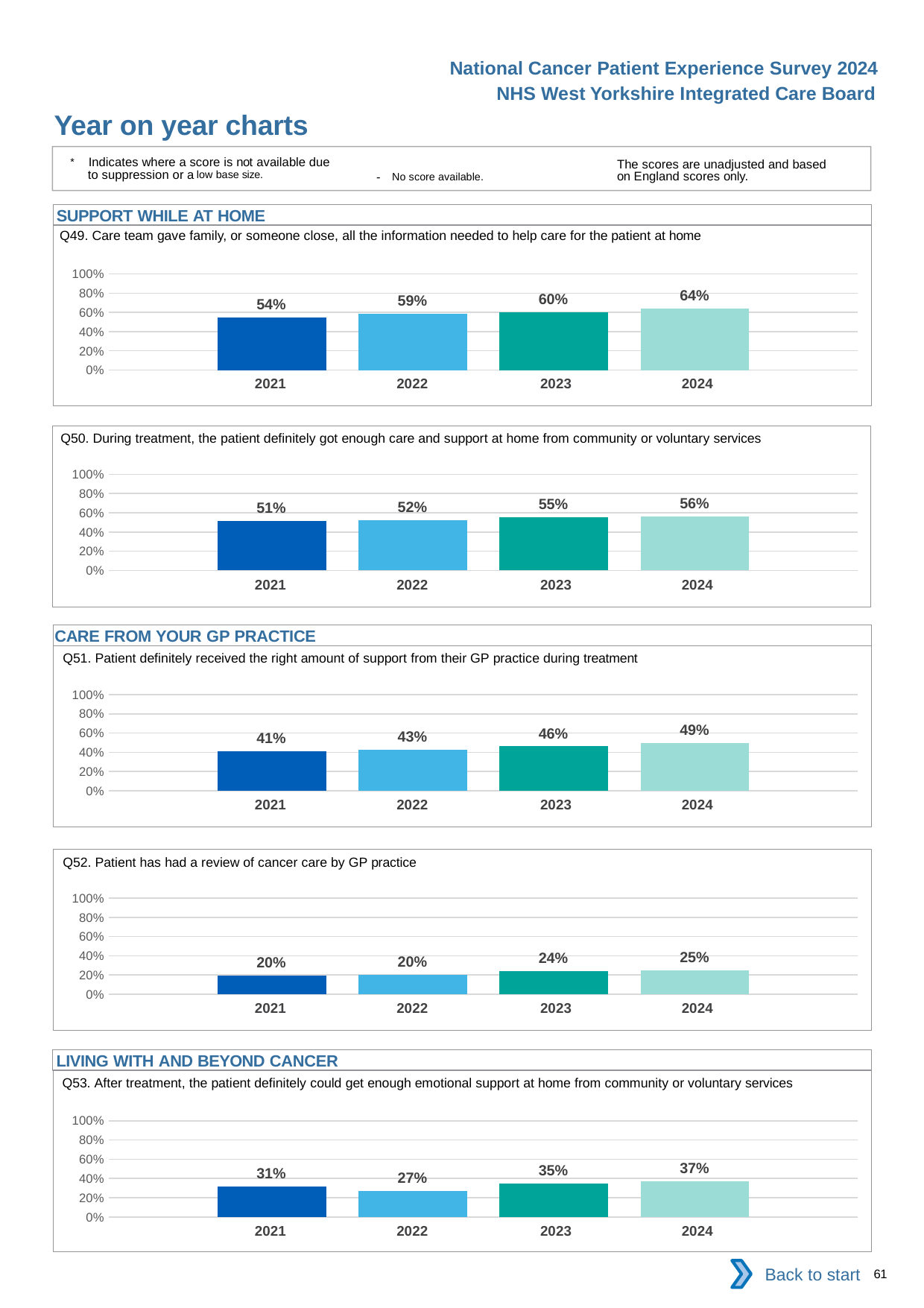
In the Q49 chart, what is the value for 2024? 64% How many years are shown in the Q50 chart? 4 In the Q53 chart, which is larger, the value for 2021 or the value for 2022? 2021 In the Q53 chart, which year has the highest value? 2024 What kind of chart is the Q52 chart? bar chart Which section heading appears above the Q51 chart? CARE FROM YOUR GP PRACTICE In the Q52 chart, what is the value for 2023? 24% In the Q50 chart, which year has the lowest value? 2021 In the Q49 chart, do the values rise or fall from 2021 to 2024? rise In the Q51 chart, what is the difference between the 2024 and 2021 values? 8 percentage points In the Q52 chart, what is the value for 2021? 20% In the Q50 chart, what is the difference between the 2023 and 2022 values? 3 percentage points